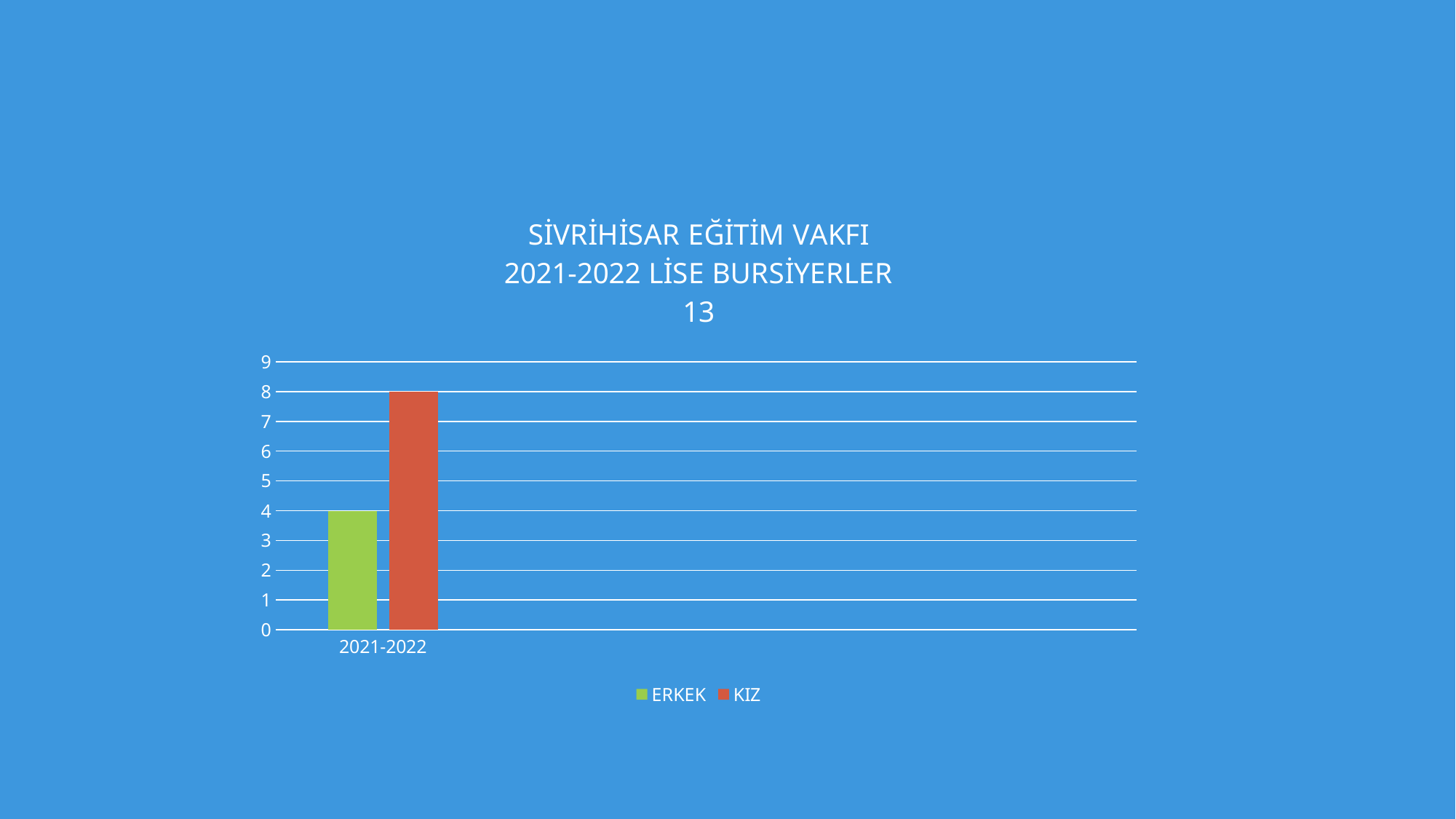
Is the value for ERKEK greater or less than 6? less How many series does the legend list? 2 What is the difference between the KIZ and ERKEK values in 2021-2022? 4 Which series has the lower value in 2021-2022? ERKEK Is the value for ERKEK larger or smaller than the value for KIZ? smaller What is the value for KIZ in 2021-2022? 8 Which colour represents the KIZ series? red What kind of chart is shown on the slide? bar chart Which series has the higher value in 2021-2022, ERKEK or KIZ? KIZ How many categories are shown on the x axis? 1 What is the value for ERKEK in 2021-2022? 4 Is the value for KIZ greater or less than 5? greater